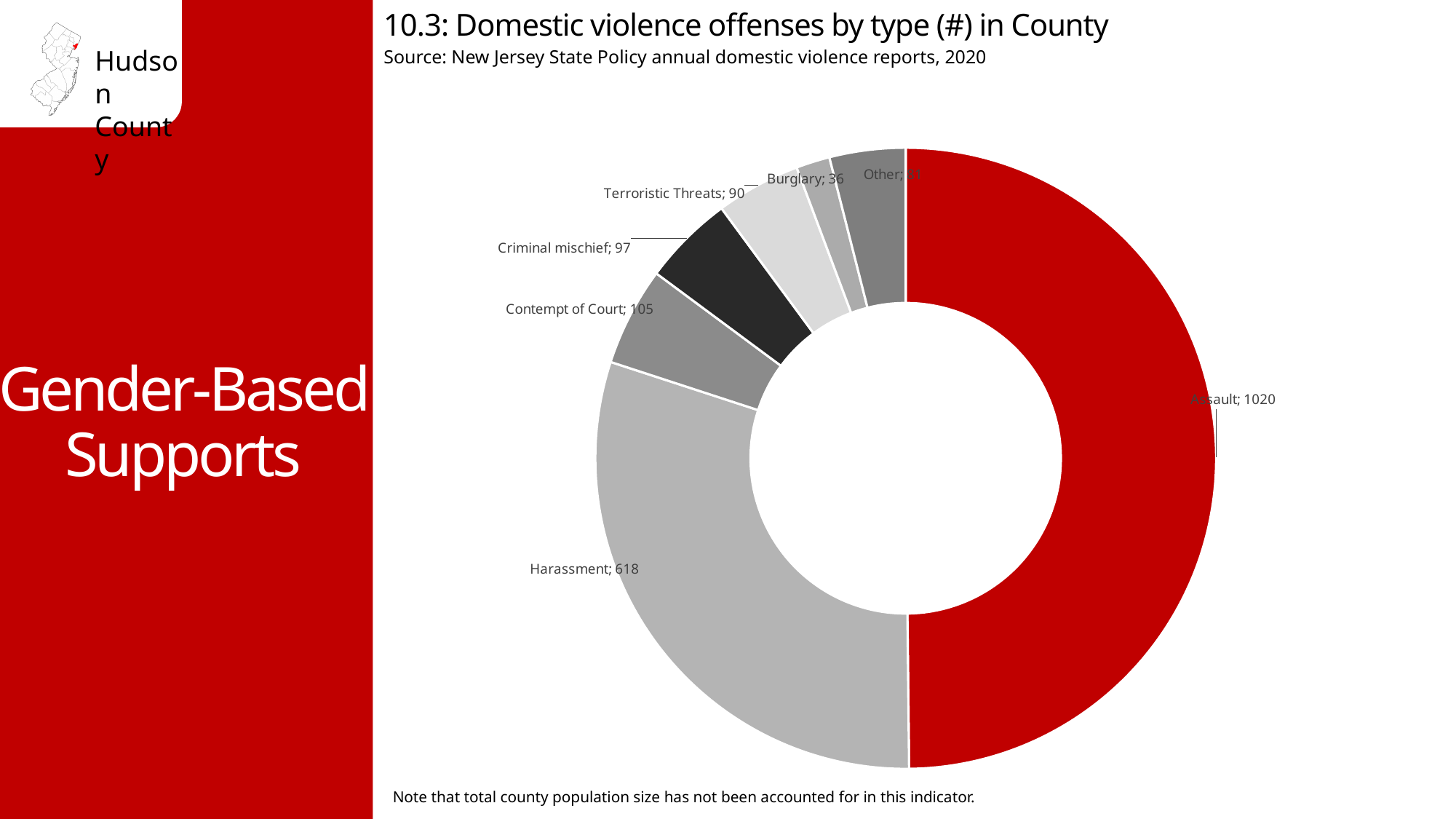
What is the value for Contempt of Court? 105 How many offense types (slices) are shown on the chart? 7 What kind of chart is used on this slide? doughnut (pie) chart What is the value for Harassment on the chart? 618 What is the value for Terroristic Threats? 90 What is the value for Burglary? 36 Which is larger, the value for Contempt of Court or the value for Criminal mischief? Contempt of Court How many domestic violence offenses of type Assault are shown on the chart? 1020 What is the difference between the Assault and Harassment values? 402 Which offense type has the highest number of offenses? Assault Which offense type has the lowest number of offenses? Burglary What is the value for Criminal mischief? 97